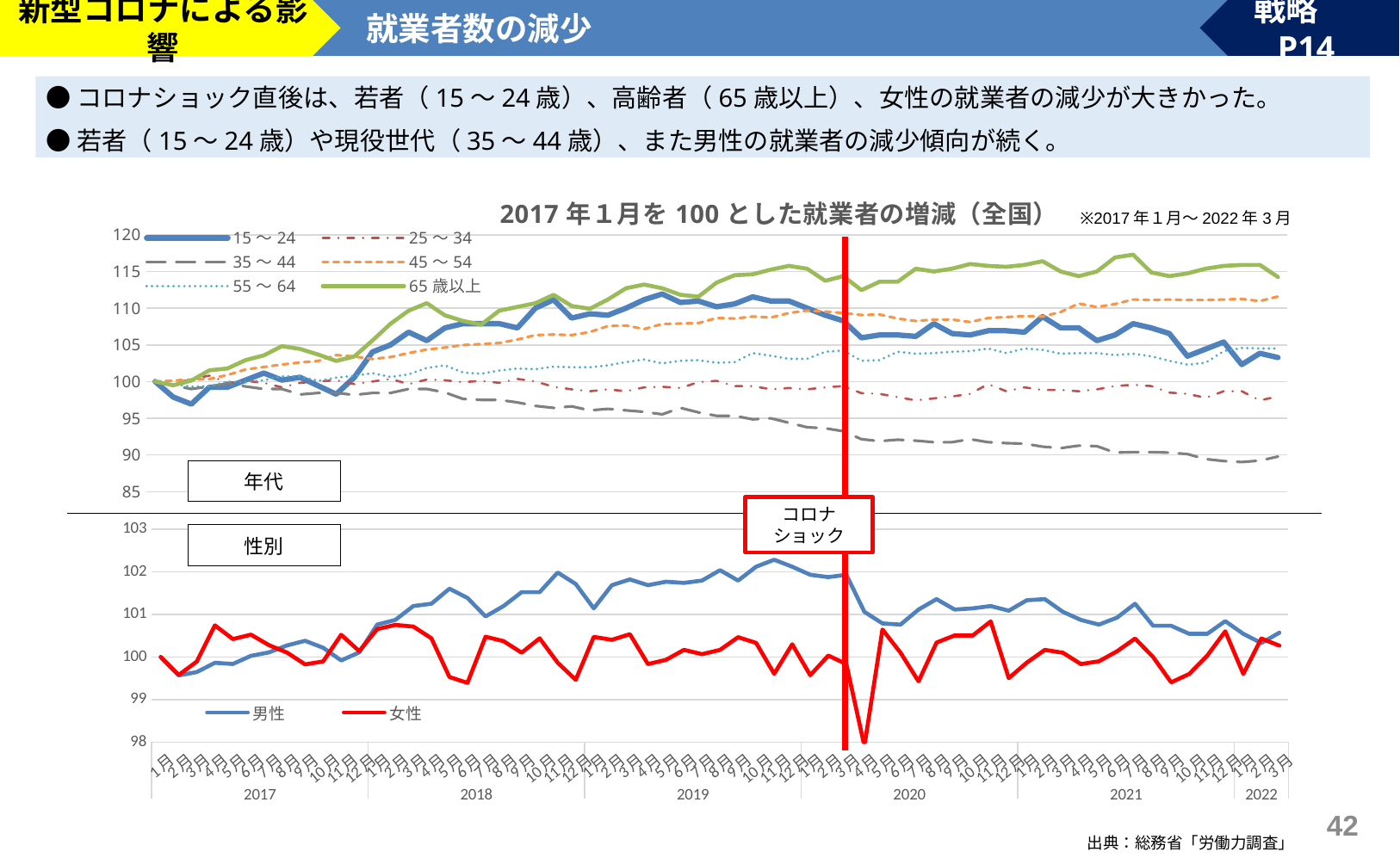
What label is attached to the red vertical line that crosses both charts? コロナショック In the bottom chart (性別), is the lowest value of the 女性 series greater or less than 99? less In the top chart (年代), which age group has the lowest value at the end of the period (2022年3月)? 35～44 How many series does the legend of the top chart (年代) list? 6 In the top chart (年代), is the value for 65歳以上 at 2022年3月 greater or less than 110? greater What kind of chart is the top chart labelled 年代? line chart How many series does the legend of the bottom chart (性別) list? 2 In the top chart (年代), which age group has the highest value at the end of the period (2022年3月)? 65歳以上 In the top chart (年代), is the value for 35～44 at 2022年3月 greater or less than 95? less In the top chart (年代), does the 35～44 series rise or fall over the period from 2017 to 2022? fall What is the title of the chart on the slide? 2017年1月を100とした就業者の増減（全国）